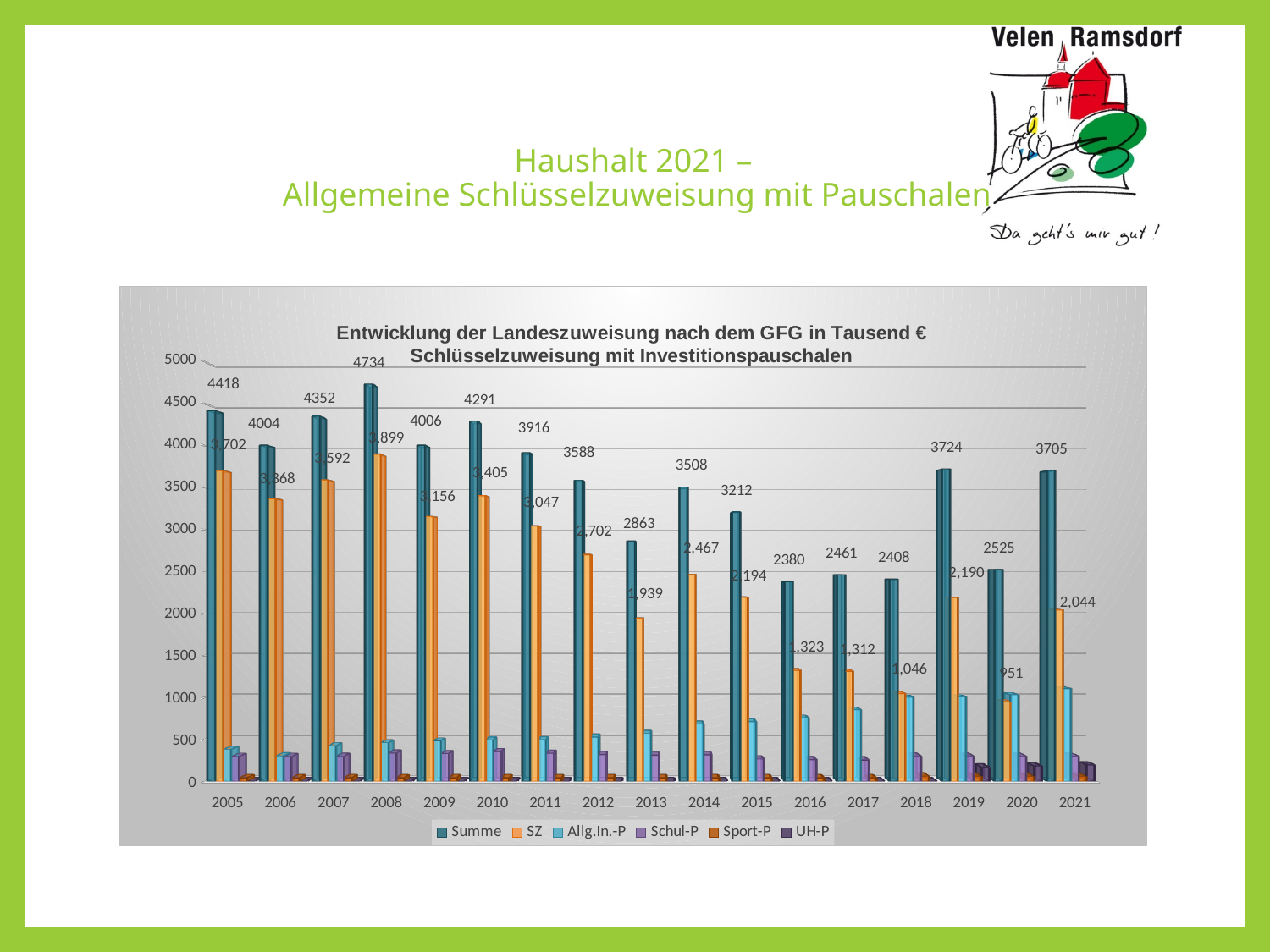
In which year is the SZ value lowest? 2020 What is the Summe value for 2008? 4734 What is the SZ value for 2020? 951 In which year is the Summe value lowest? 2016 What is the difference between the Summe values for 2008 and 2016? 2354 What kind of chart is shown on the slide? bar chart Which is larger, the Summe value for 2005 or for 2006? 2005 Is the value for Allg.In.-P in 2021 greater or less than 1000? greater What is the Summe value for 2021? 3705 How many years are shown on the x axis? 17 How many series does the legend list? 6 In which year is the Summe value highest? 2008